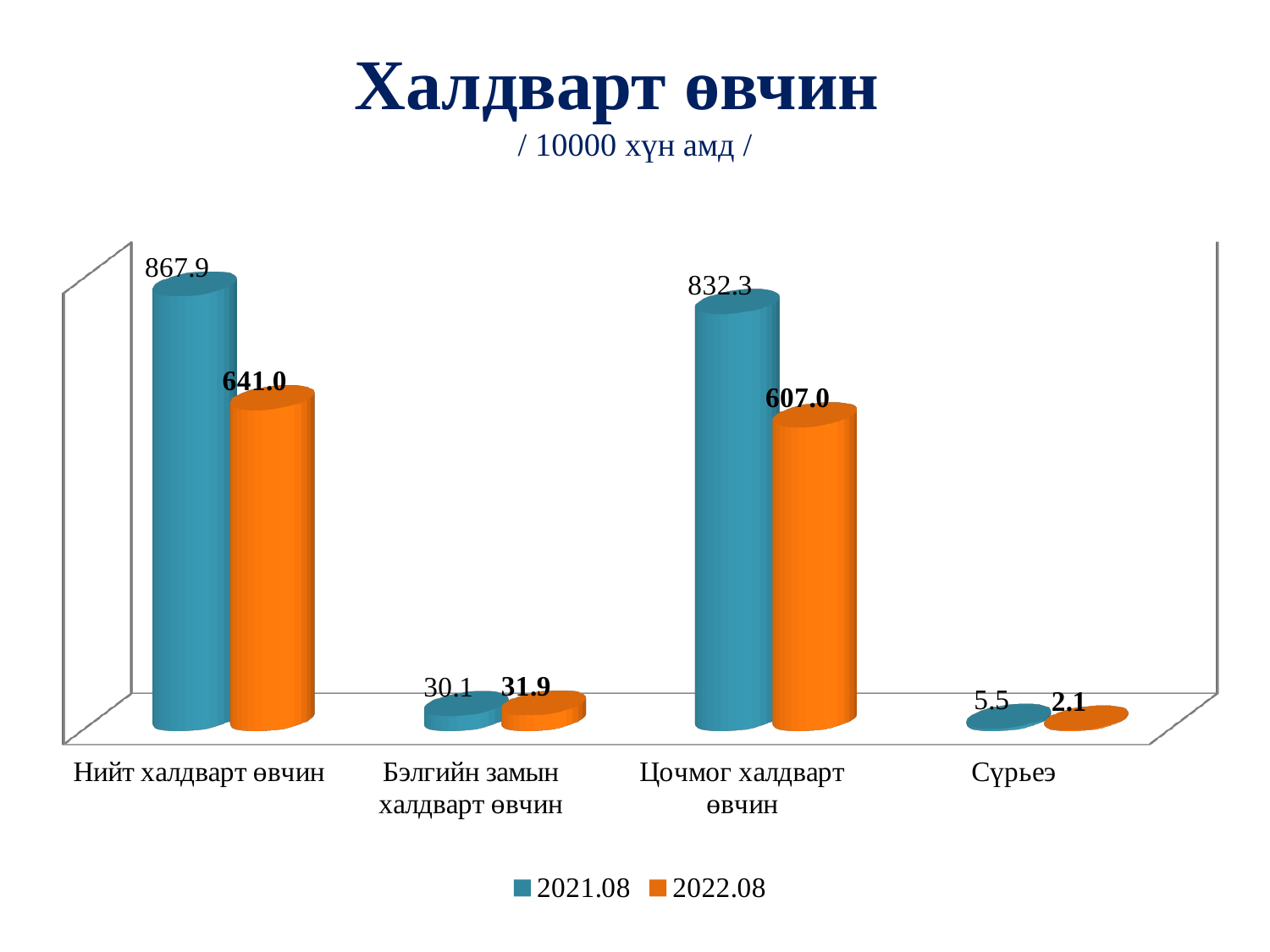
What is the value for Цочмог халдварт өвчин in the 2022.08 series? 607.0 How many categories are shown on the x axis? 4 For Бэлгийн замын халдварт өвчин, which series has the larger value, 2021.08 or 2022.08? 2022.08 What is the difference between the 2021.08 and 2022.08 values for Цочмог халдварт өвчин? 225.3 What is the value for Нийт халдварт өвчин in the 2022.08 series? 641.0 What is the value for Нийт халдварт өвчин in the 2021.08 series? 867.9 Which category has the highest value in the 2021.08 series? Нийт халдварт өвчин Which category has the lowest value in the 2022.08 series? Сүрьеэ How many series does the legend list? 2 What is the value for Сүрьеэ in the 2021.08 series? 5.5 What is the value for Бэлгийн замын халдварт өвчин in the 2022.08 series? 31.9 What type of chart is shown on the slide? Bar chart